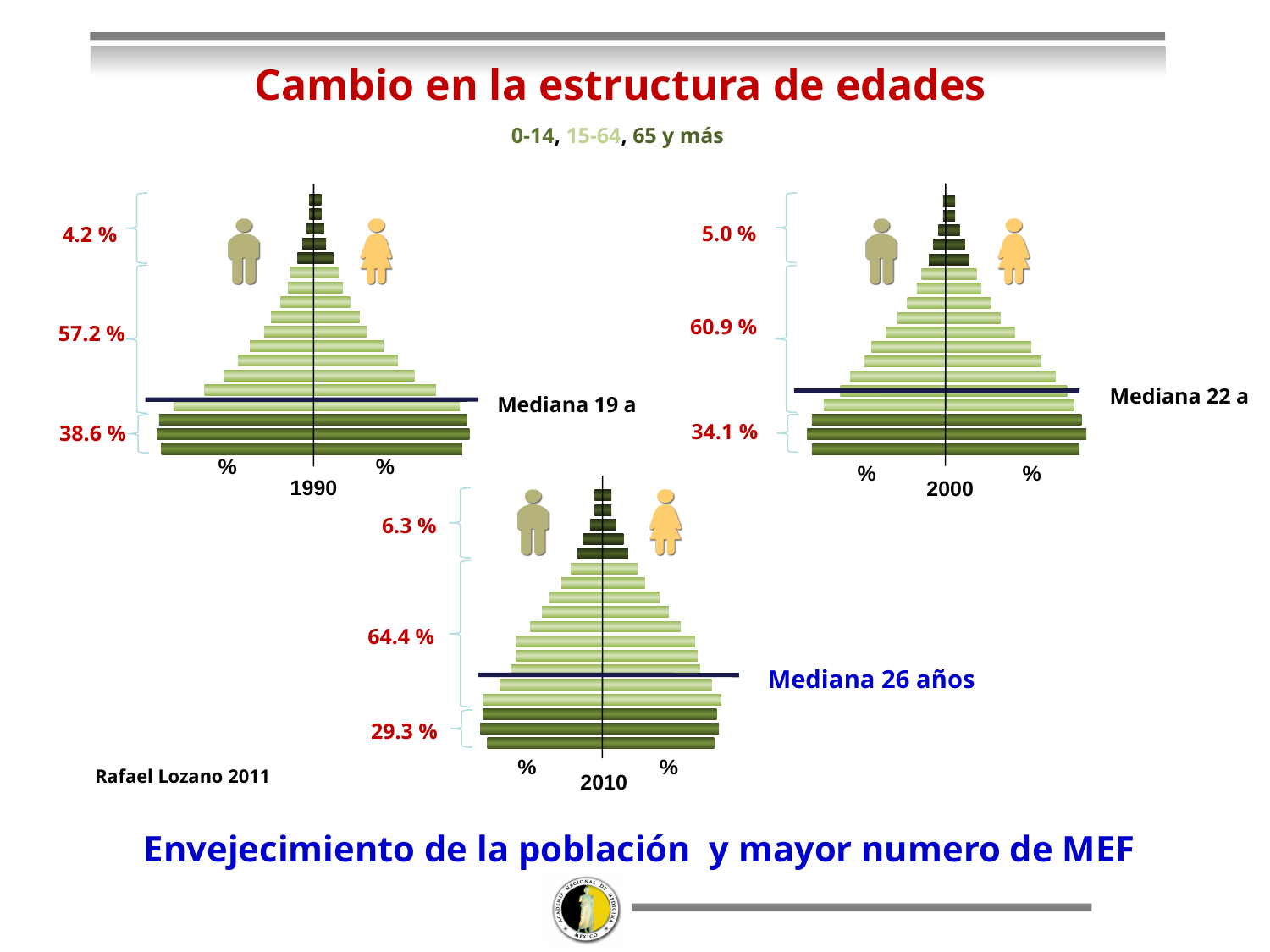
What kind of chart is used to show the age structure for each year? Population pyramid (bar chart) How many population pyramids are shown on the slide? 3 Which year's pyramid shows the highest share of population aged 65 and over? 2010 What is the difference between the 0-14 share in 1990 and the 0-14 share in 2010? 9.3 % What is the median age shown for the 2010 pyramid? 26 años How does the median age change across the 1990, 2000 and 2010 pyramids? It rises (19, 22, 26) In the 2010 pyramid, what percentage of the population is aged 0-14? 29.3 % Which year's pyramid shows the lowest share of population aged 0-14? 2010 In the 1990 pyramid, what percentage of the population is aged 65 and over? 4.2 % What is the title of the slide? Cambio en la estructura de edades In the 2000 pyramid, what percentage of the population is aged 15-64? 60.9 % Which is larger: the 15-64 share in 1990 or the 15-64 share in 2000? 2000